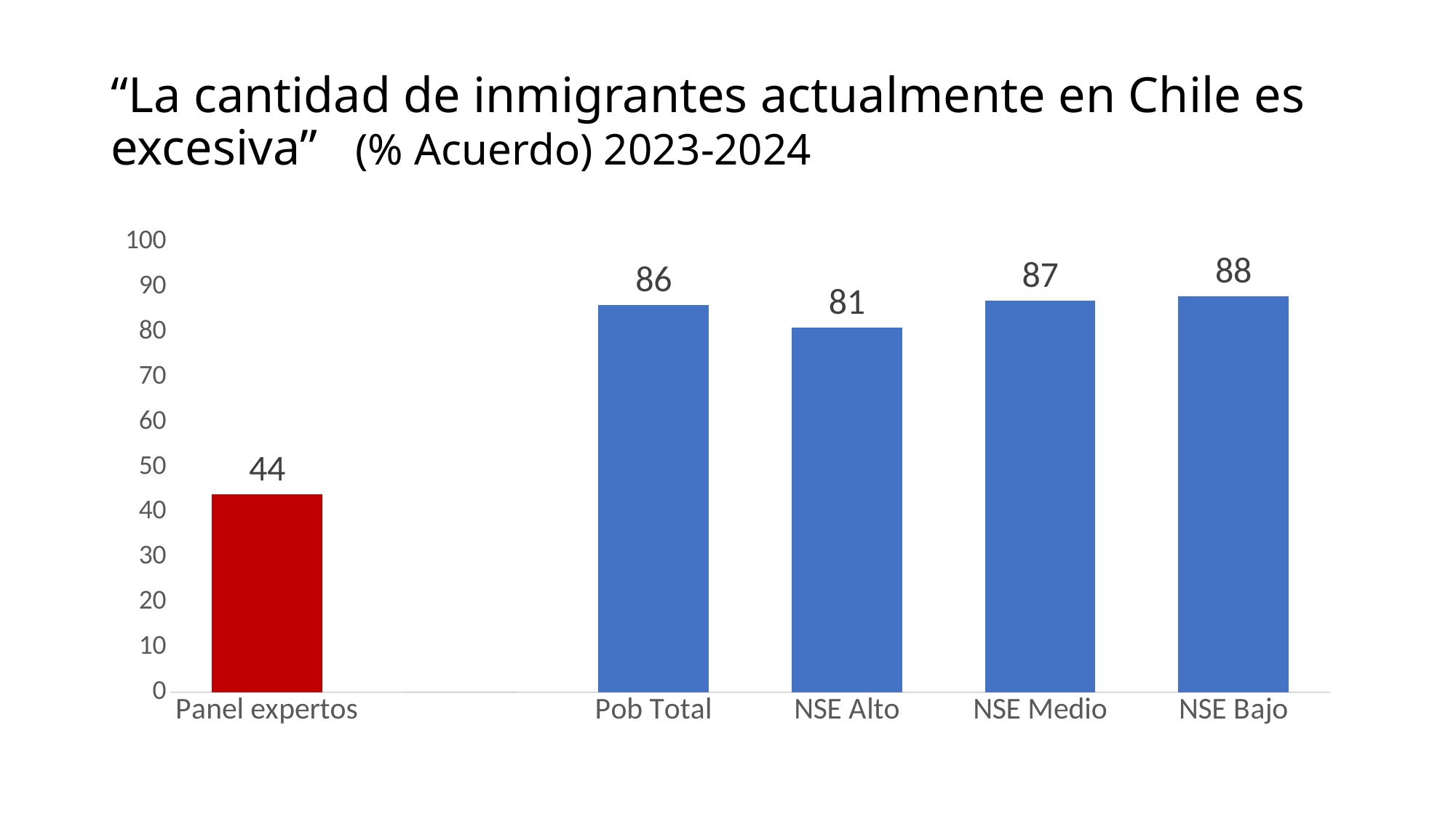
What kind of chart is shown on the slide? bar chart What is the value for Panel expertos? 44 Which category has the highest value? NSE Bajo What is the value for Pob Total? 86 Which category has the lowest value? Panel expertos What is the value for NSE Bajo? 88 Which bar is coloured red? Panel expertos How many categories are shown on the x axis? 5 What is the difference between the values for NSE Bajo and Panel expertos? 44 What is the difference between the values for NSE Medio and NSE Alto? 6 What is the value for NSE Alto? 81 Which is larger, the value for Pob Total or the value for NSE Alto? Pob Total